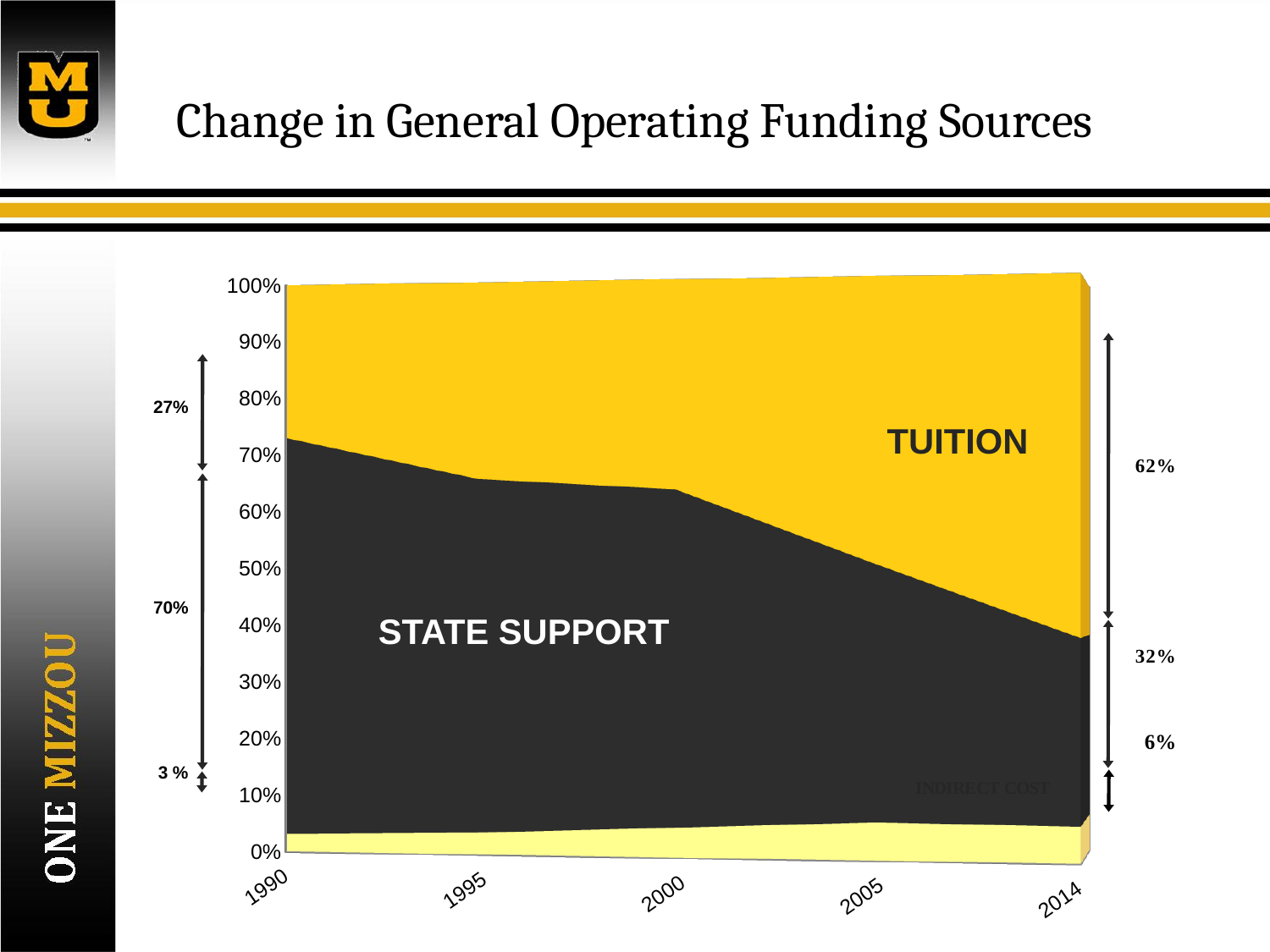
What is the title of the chart? Change in General Operating Funding Sources Is the state support share in 2000 greater or less than 50%? greater What share of general operating funding came from tuition in 2014? 62% What share of general operating funding came from indirect cost in 2014? 6% What share of general operating funding came from tuition in 1990? 27% How many years are labeled on the x axis? 5 What share of general operating funding came from state support in 2014? 32% What share of general operating funding came from state support in 1990? 70% What type of chart is shown on the slide? Stacked area chart Does the state support share rise or fall from 1990 to 2014? Fall In 2014, which is larger: the tuition share or the state support share? Tuition By how many percentage points did the tuition share increase from 1990 to 2014? 35